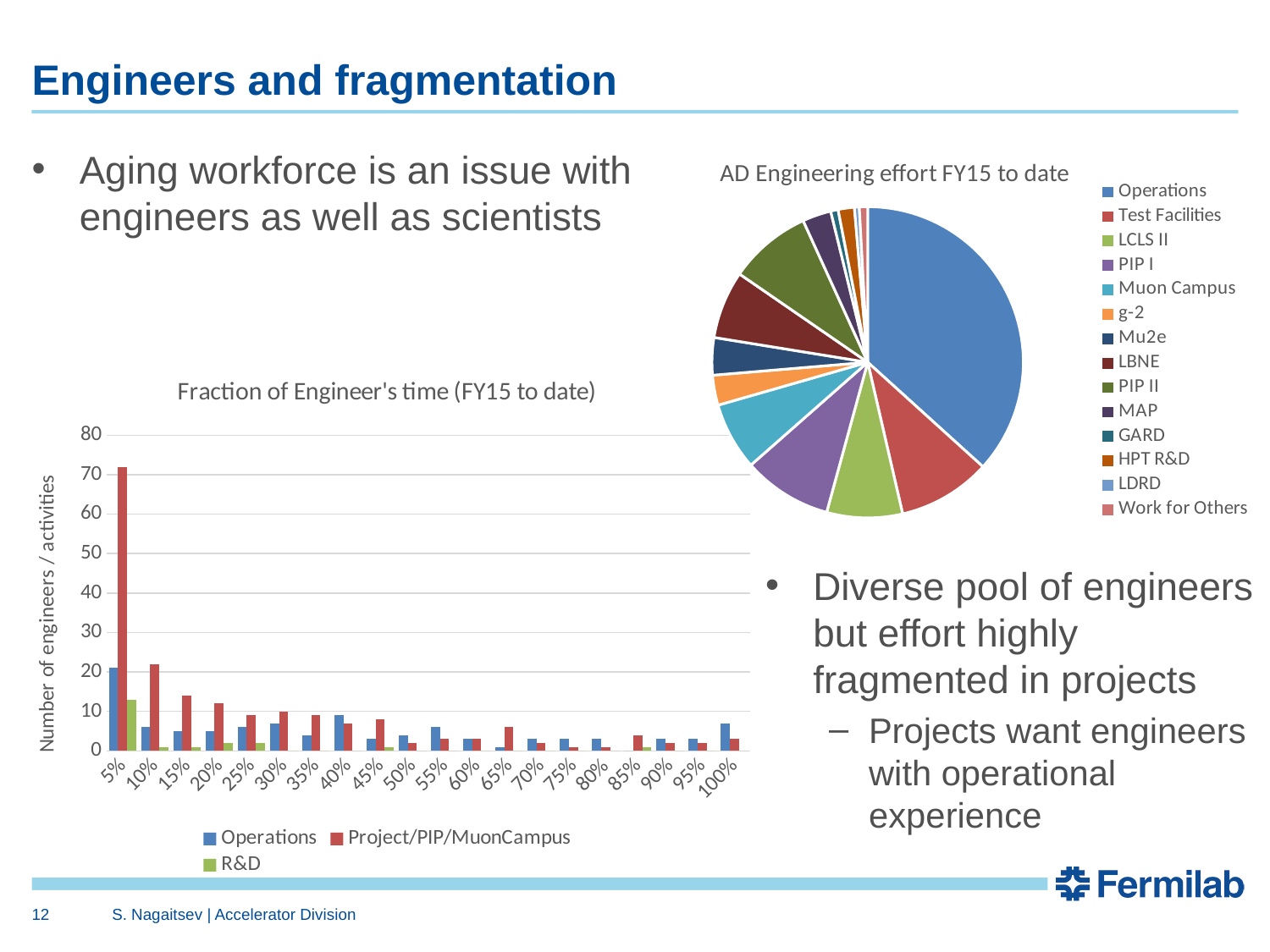
In the "AD Engineering effort FY15 to date" pie chart, how many entries does the legend list? 14 In the "Fraction of Engineer's time (FY15 to date)" chart, is the Project/PIP/MuonCampus value at 5% greater or less than 60? greater In the "Fraction of Engineer's time (FY15 to date)" chart, at the 10% category, which is larger: Operations or Project/PIP/MuonCampus? Project/PIP/MuonCampus What kind of chart is the chart titled "AD Engineering effort FY15 to date"? pie chart In the "Fraction of Engineer's time (FY15 to date)" chart, is the Operations value at 5% greater or less than 30? less What kind of chart is the chart titled "Fraction of Engineer's time (FY15 to date)"? bar chart In the "Fraction of Engineer's time (FY15 to date)" chart, how many categories are shown on the x axis? 20 In the "Fraction of Engineer's time (FY15 to date)" chart, how many series does the legend list? 3 In the "Fraction of Engineer's time (FY15 to date)" chart, do the Project/PIP/MuonCampus values generally rise or fall from 5% to 100%? fall What is the y-axis label of the "Fraction of Engineer's time (FY15 to date)" chart? Number of engineers / activities In the "Fraction of Engineer's time (FY15 to date)" chart, which category has the highest Project/PIP/MuonCampus bar? 5% In the "AD Engineering effort FY15 to date" pie chart, which category has the largest slice? Operations